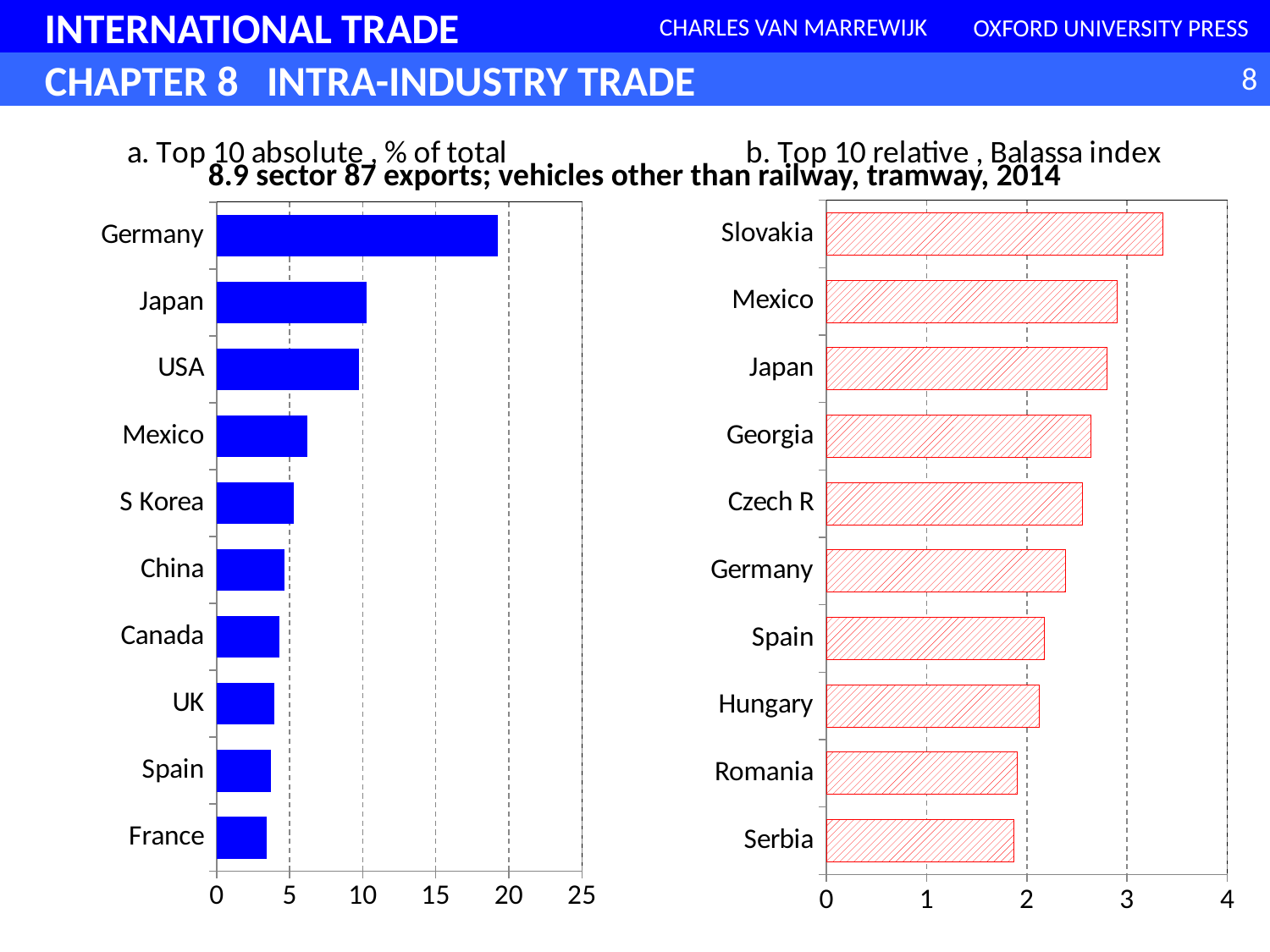
In the left chart (a. Top 10 absolute, % of total), which country has the highest value? Germany What kind of chart is the left chart (a. Top 10 absolute, % of total)? Bar chart In the left chart (a. Top 10 absolute, % of total), is the value for Mexico greater or less than 5? greater In the right chart (b. Top 10 relative, Balassa index), is the value for Slovakia greater or less than 3? greater In the left chart (a. Top 10 absolute, % of total), which is larger, the value for Japan or the value for Mexico? Japan In the left chart (a. Top 10 absolute, % of total), is the value for Germany greater or less than 15? greater How many countries are shown in the right chart (b. Top 10 relative, Balassa index)? 10 In the right chart (b. Top 10 relative, Balassa index), which is larger, the value for Germany or the value for Mexico? Mexico In the right chart (b. Top 10 relative, Balassa index), which country has the highest value? Slovakia In the left chart (a. Top 10 absolute, % of total), which country has the lowest value? France